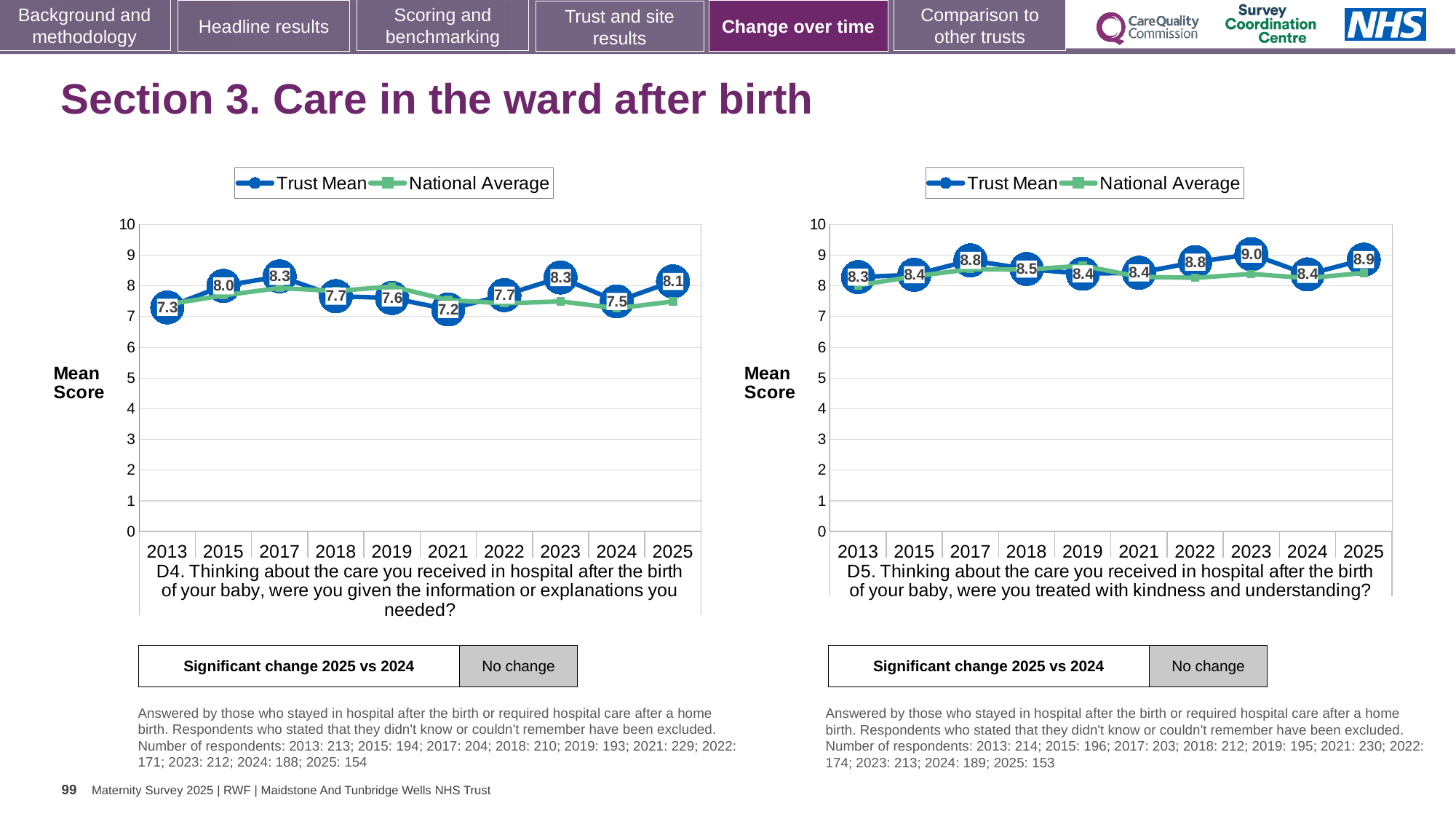
How many years are shown on the x axis of the right chart (D5)? 10 How many series does the legend of the left chart (D4) list? 2 In the right chart (D5), what is the Trust Mean score for 2025? 8.9 In the left chart (D4), which is larger, the Trust Mean score for 2017 or for 2018? 2017 In the right chart (D5), which year has the highest Trust Mean score? 2023 In the left chart (D4), which year has the lowest Trust Mean score? 2021 In the left chart (D4), what is the Trust Mean score for 2013? 7.3 What kind of chart is the right chart (D5)? Line chart In the left chart (D4), what is the Trust Mean score for 2025? 8.1 In the right chart (D5), what is the difference between the Trust Mean scores for 2023 and 2024? 0.6 In the left chart (D4), is the National Average value for 2025 greater or less than 8? less In the right chart (D5), which year has the lowest Trust Mean score? 2013